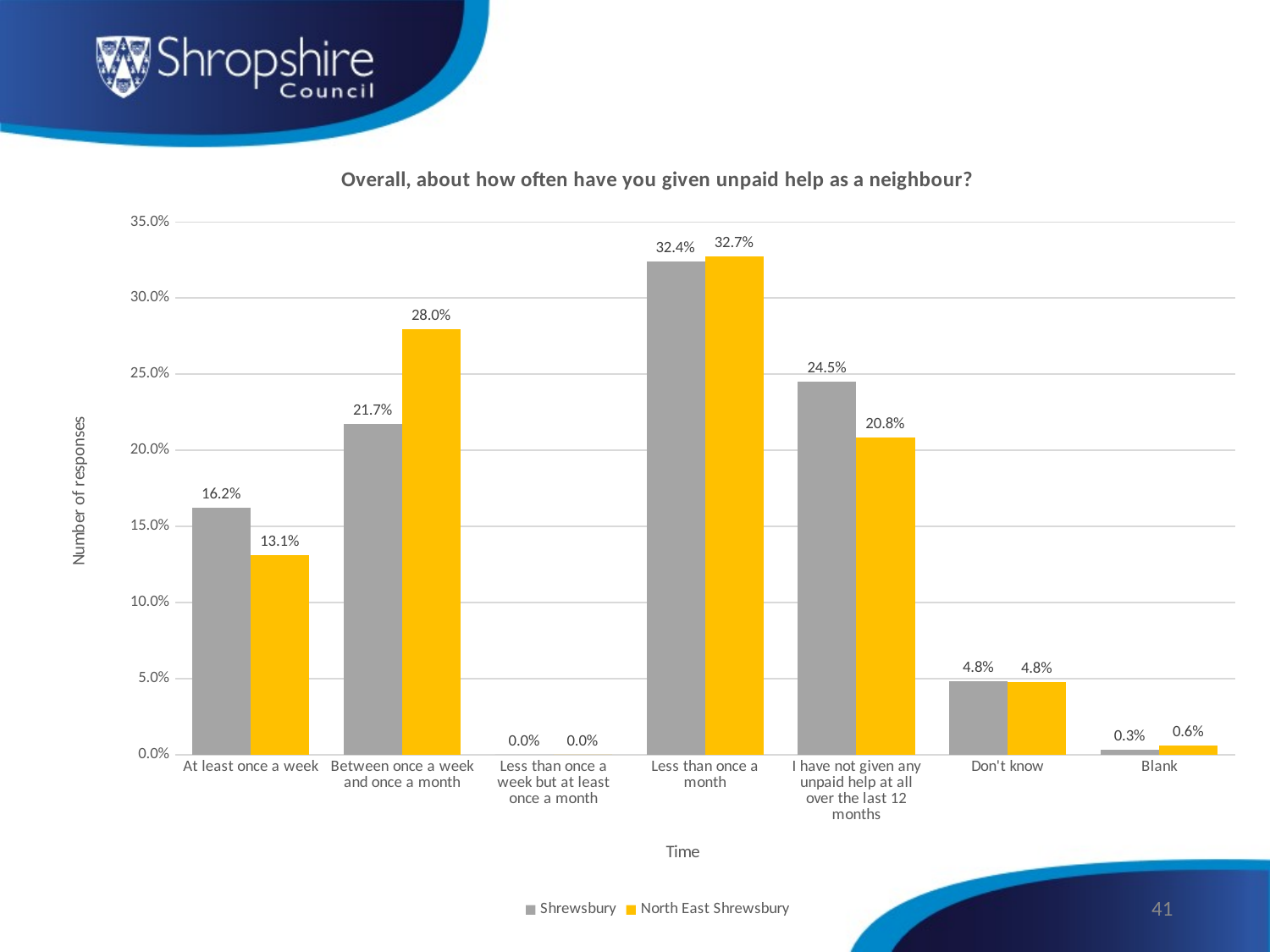
Which is larger in the 'At least once a week' category: Shrewsbury or North East Shrewsbury? Shrewsbury What is the value for Shrewsbury in the 'At least once a week' category? 16.2% Which category has the highest value for North East Shrewsbury? Less than once a month What kind of chart is shown on the slide? Bar chart What is the value for Shrewsbury in the 'Less than once a month' category? 32.4% How many categories are shown on the x axis? 7 What is the value for North East Shrewsbury in the 'Between once a week and once a month' category? 28.0% What is the title of the chart? Overall, about how often have you given unpaid help as a neighbour? What is the difference between Shrewsbury and North East Shrewsbury in the 'I have not given any unpaid help at all over the last 12 months' category? 3.7% What is the label of the y axis? Number of responses Which category has the lowest value for Shrewsbury? Less than once a week but at least once a month How many series does the legend list? 2